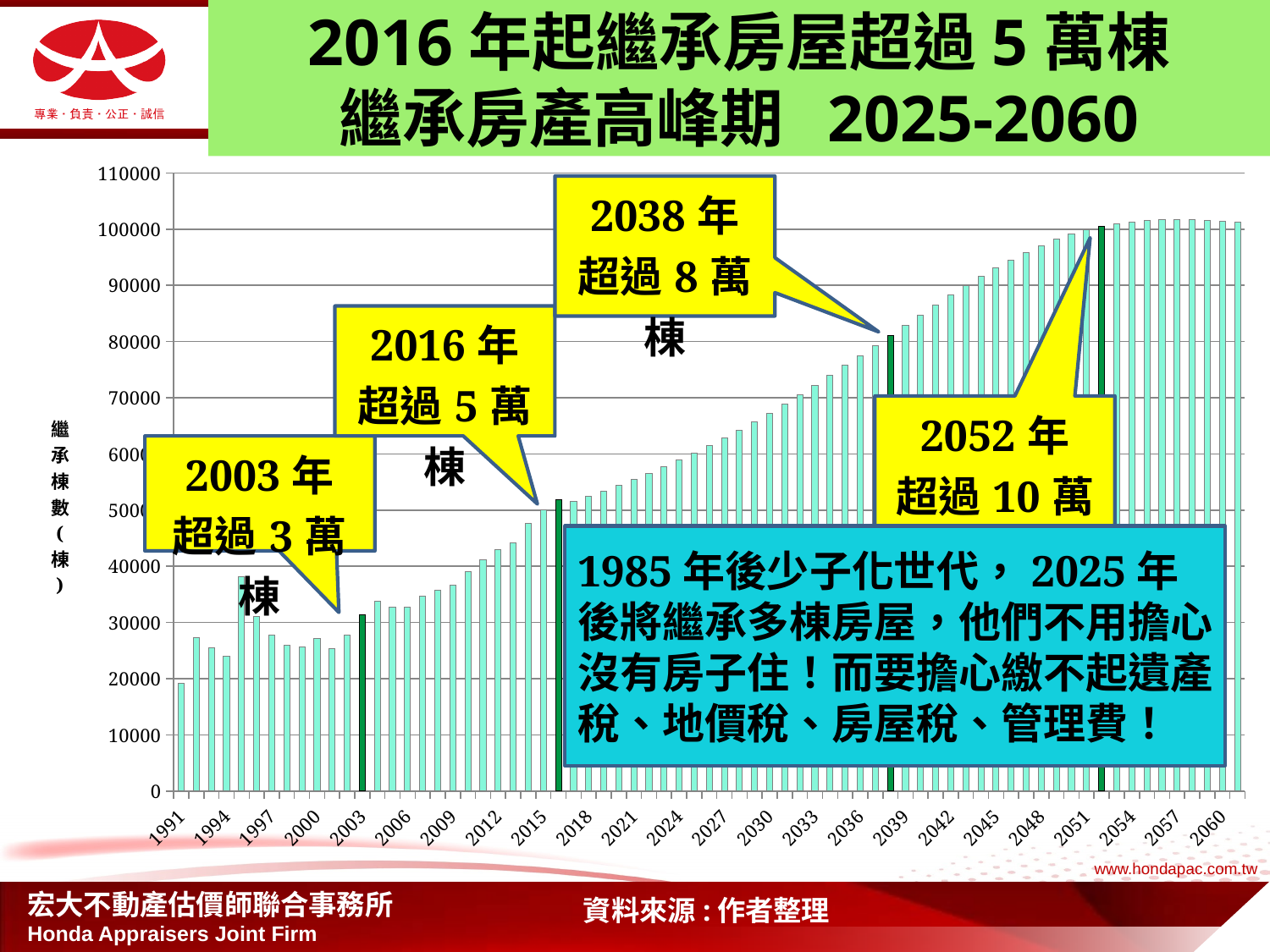
What is the first year shown on the x axis? 1991 What kind of chart is shown on the slide? bar chart Is the value for 2045 greater or less than 90000? greater Is the value for 2016 greater or less than 50000? greater Is the value for 2038 greater or less than 80000? greater Do the values rise or fall along the x axis from 2016 to 2052? rise What is the highest tick value shown on the y axis? 110000 Which year has the lowest value in the chart? 1991 Which is larger, the value for 2016 or the value for 2038? 2038